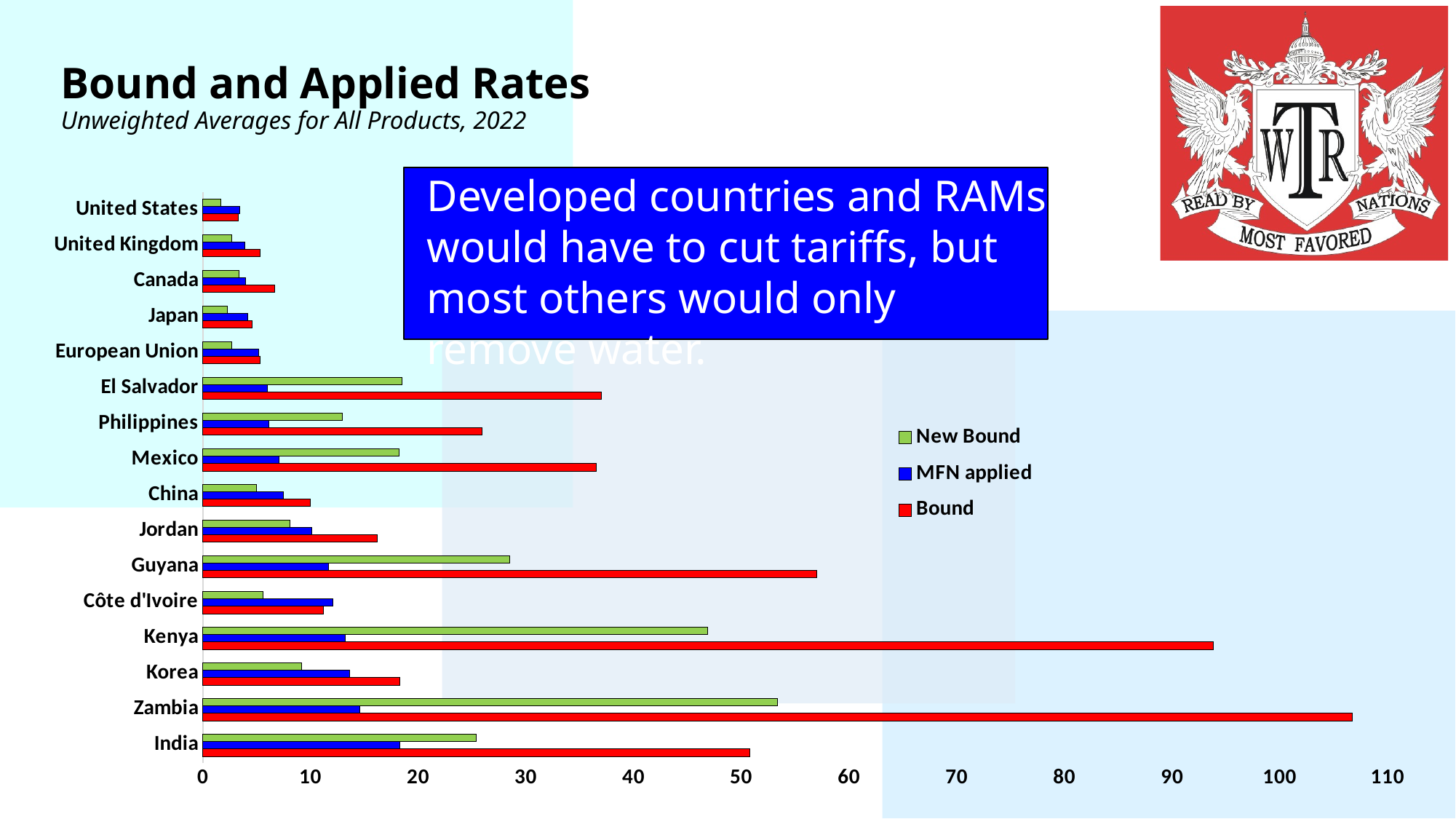
Is the Bound value for Philippines greater or less than 30? less Which country has the highest MFN applied rate? India Which country has the highest Bound rate? Zambia Which country has the highest New Bound rate? Zambia How many countries are listed on the chart? 16 Which is larger, the Bound value for Kenya or the Bound value for Guyana? Kenya Is the Bound value for Kenya greater or less than 90? greater Is the New Bound value for Kenya greater or less than 40? greater How many series does the legend list? 3 What is the subtitle of the chart? Unweighted Averages for All Products, 2022 What kind of chart is shown on the slide? bar chart